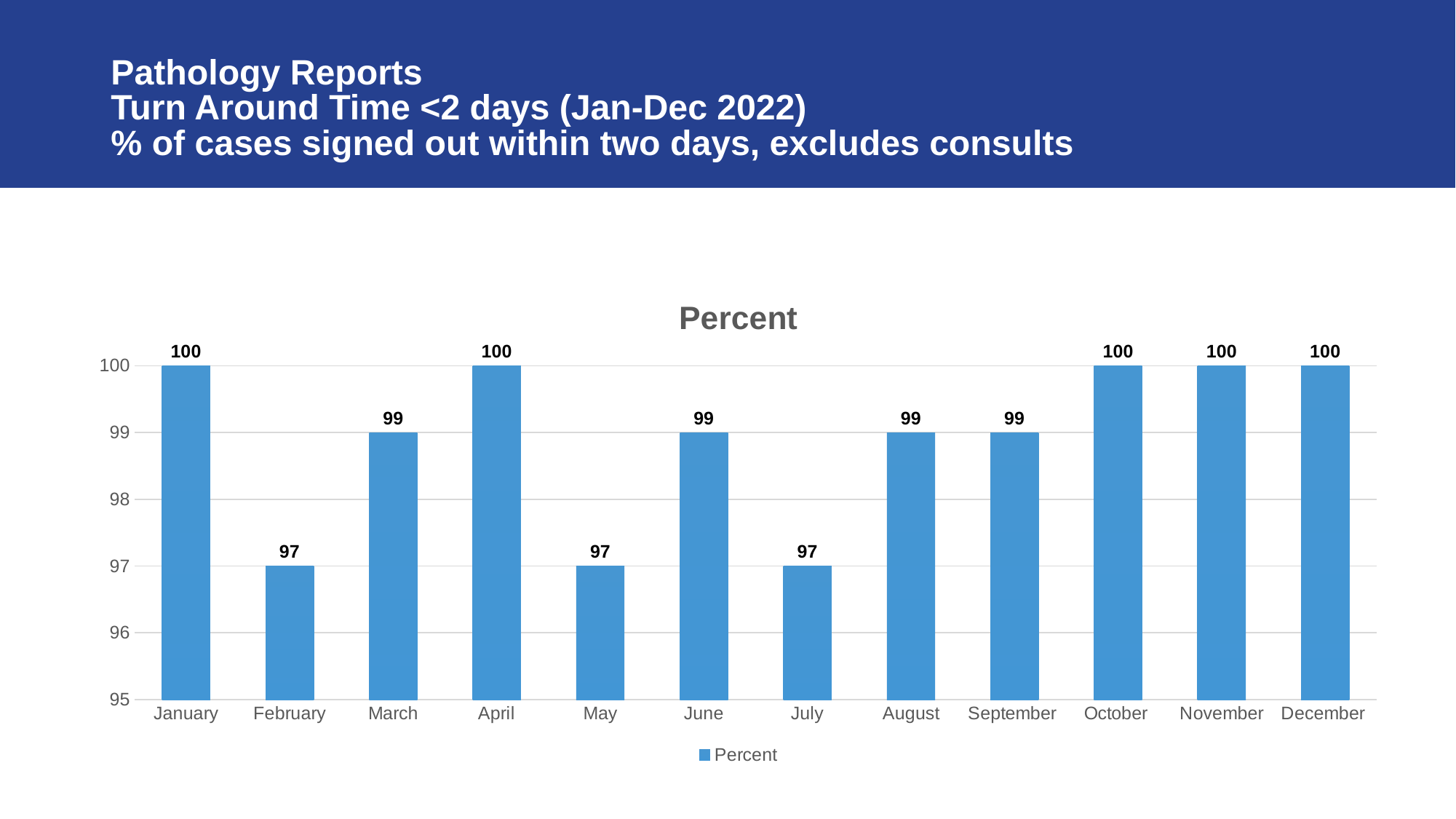
What is the value for February? 97 What is the value for January? 100 How many series does the legend list? 1 How many months are shown on the x axis? 12 Which months have the lowest value? February, May, July What is the value for September? 99 What is the difference between the values for March and February? 2 Is the value for May greater or less than 98? less What kind of chart is shown? bar chart What is the difference between the values for April and May? 3 What is the value for July? 97 Which is larger, the value for June or the value for July? June